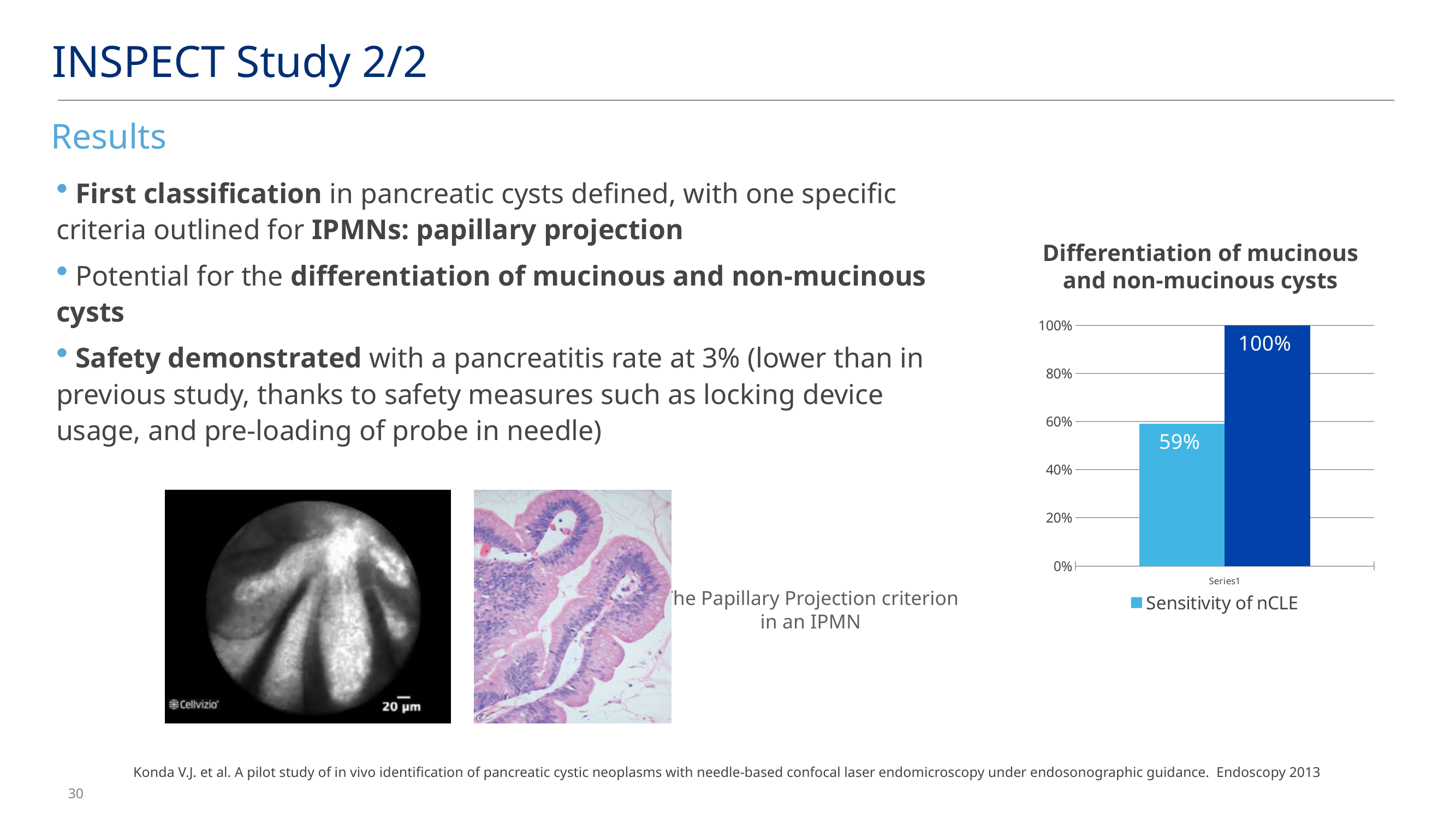
Is the value of the light blue bar greater or less than 40%? greater Which bar has the lowest value in the chart? the light blue bar (59%) What is the difference between the dark blue bar and the light blue bar in the chart? 41% Which is larger in the chart, the light blue bar or the dark blue bar? the dark blue bar What value is shown on the light blue bar in the chart? 59% What is the title of the chart? Differentiation of mucinous and non-mucinous cysts What kind of chart is shown on the slide? bar chart What is the legend entry shown below the chart? Sensitivity of nCLE Which bar has the highest value in the chart? the dark blue bar (100%) What value is shown on the dark blue bar in the chart? 100% How many bars are plotted in the chart? 2 How many entries does the chart legend list? 1